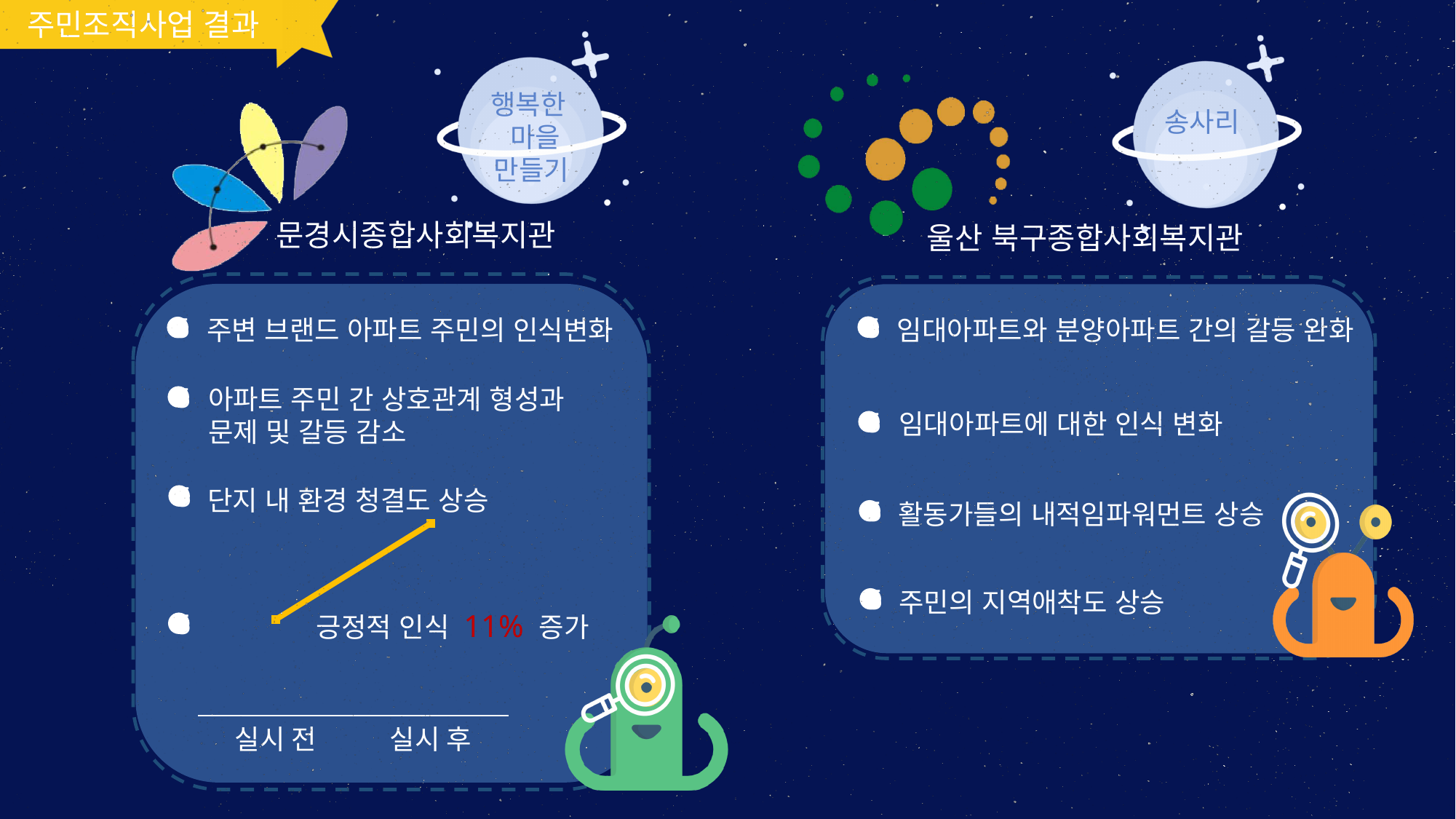
Does the line in the 문경시종합사회복지관 chart rise or fall from 실시 전 to 실시 후? rise What are the two x-axis labels on the line chart in the 문경시종합사회복지관 box? 실시 전, 실시 후 Which point on the line chart is higher, 실시 전 or 실시 후? 실시 후 What kind of chart is shown in the 문경시종합사회복지관 box? line chart According to the annotation on the line chart, by how much did 긍정적 인식 increase? 11% How many points are plotted on the line chart in the 문경시종합사회복지관 box? 2 What colour is the line in the chart in the 문경시종합사회복지관 box? yellow